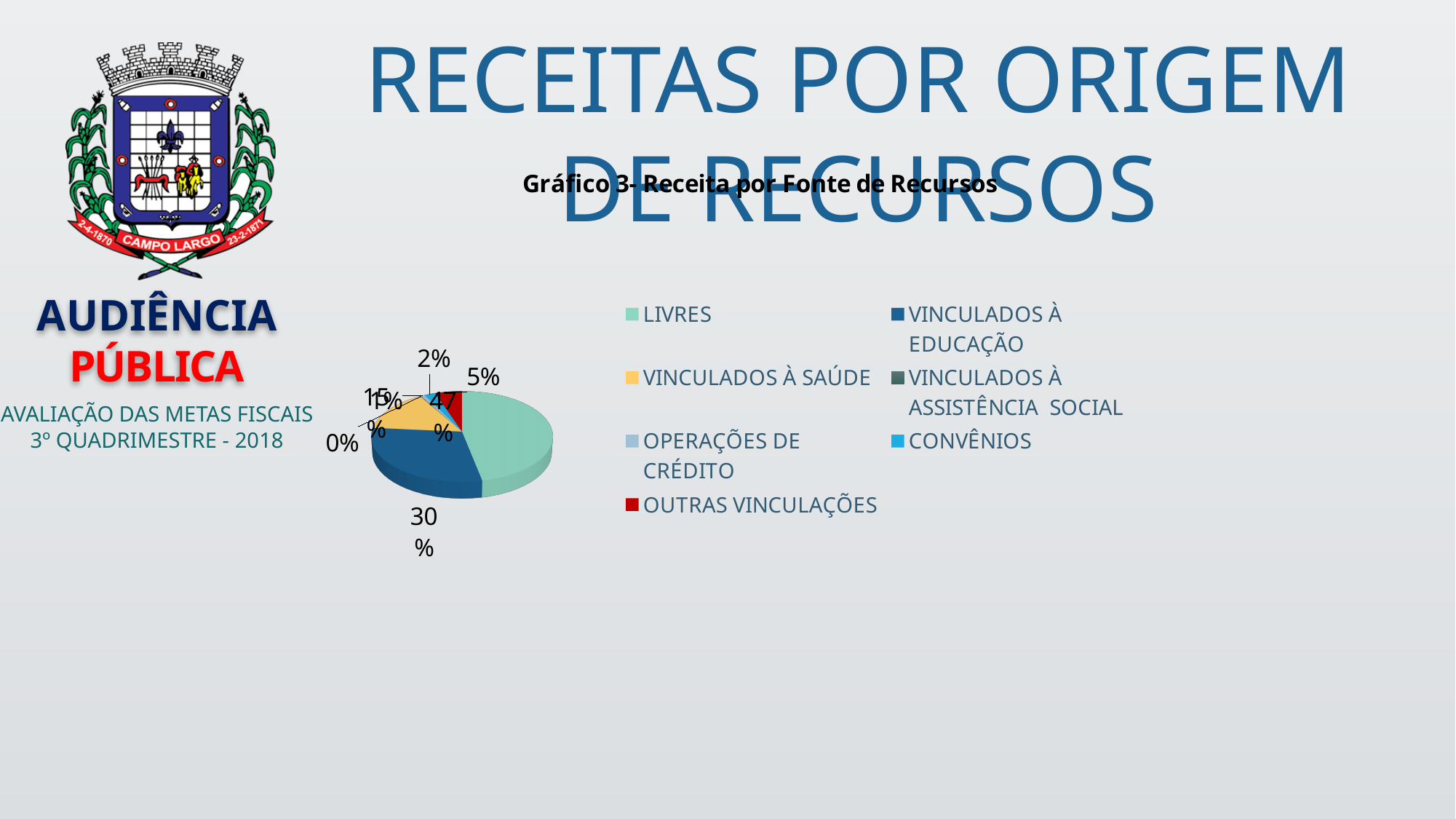
What share of the pie does CONVÊNIOS represent? 2% What is the difference in percentage points between the LIVRES share and the VINCULADOS À EDUCAÇÃO share? 17 What share of the pie does LIVRES represent? 47% What share of the pie does VINCULADOS À EDUCAÇÃO represent? 30% Which is larger, the share for VINCULADOS À SAÚDE or the share for OUTRAS VINCULAÇÕES? VINCULADOS À SAÚDE What kind of chart is shown on the slide? Pie chart What colour is the LIVRES slice in the pie chart? Light green Which category has the largest share of the pie? LIVRES What is the title of the chart on the slide? Gráfico 3- Receita por Fonte de Recursos How many entries does the chart's legend list? 7